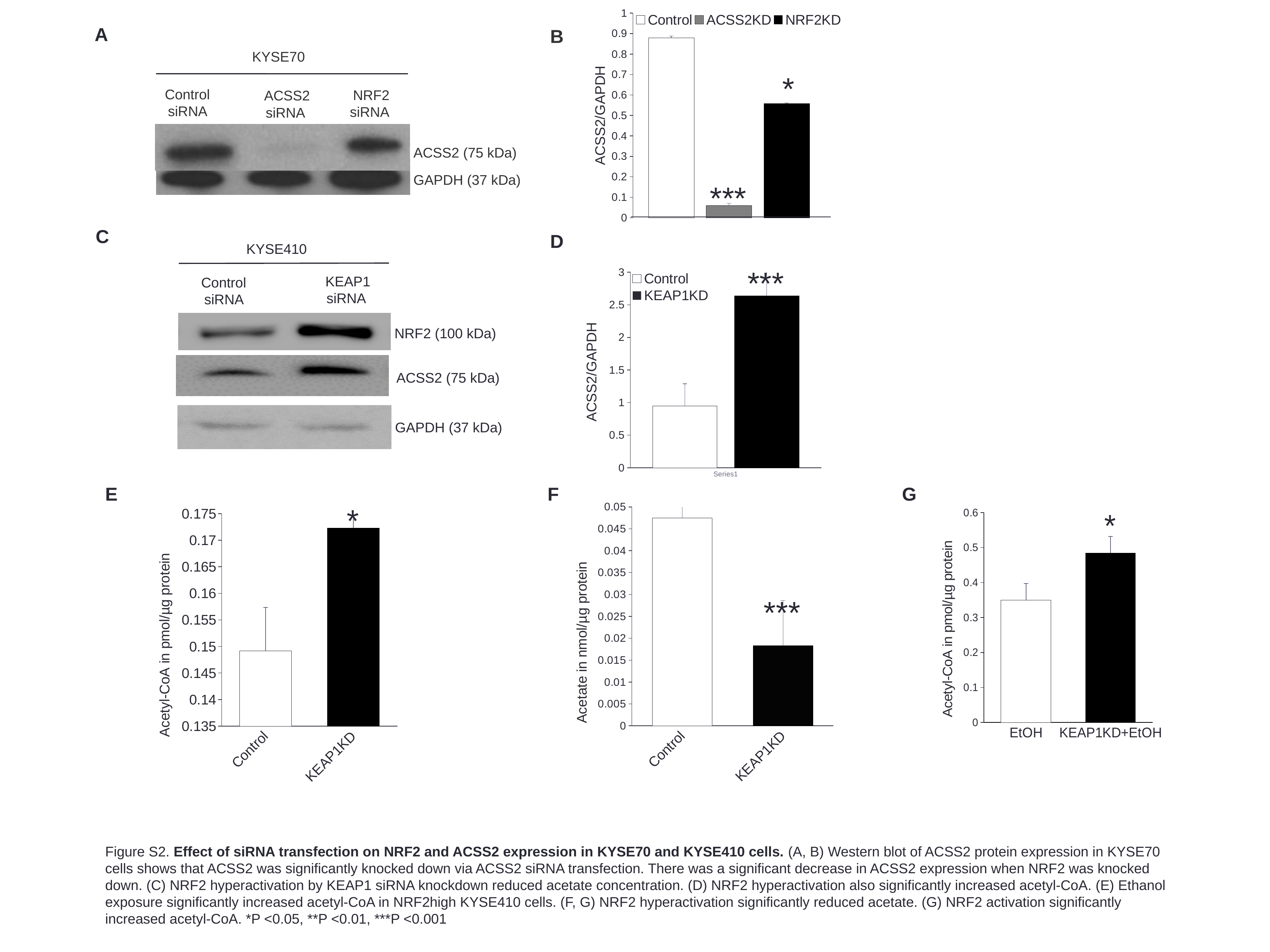
In chart F (Acetate in nmol/µg protein), which group has the lower bar? KEAP1KD In chart D (ACSS2/GAPDH, KEAP1KD), is the value for KEAP1KD greater or less than 2.5? greater In chart B (ACSS2/GAPDH, top right), which group has the highest bar? Control In chart F (Acetate in nmol/µg protein), is the value for KEAP1KD greater or less than 0.02? less In chart B (ACSS2/GAPDH, top right), which group has the lowest bar? ACSS2KD In chart B (ACSS2/GAPDH, top right), how many series does the legend list? 3 In chart E (Acetyl-CoA in pmol/µg protein), which group has the higher bar? KEAP1KD What kind of chart is chart G (Acetyl-CoA in pmol/µg protein, EtOH)? bar chart In chart B (ACSS2/GAPDH, top right), is the value for NRF2KD greater or less than 0.5? greater In chart D (ACSS2/GAPDH, KEAP1KD), which group has the larger value, Control or KEAP1KD? KEAP1KD